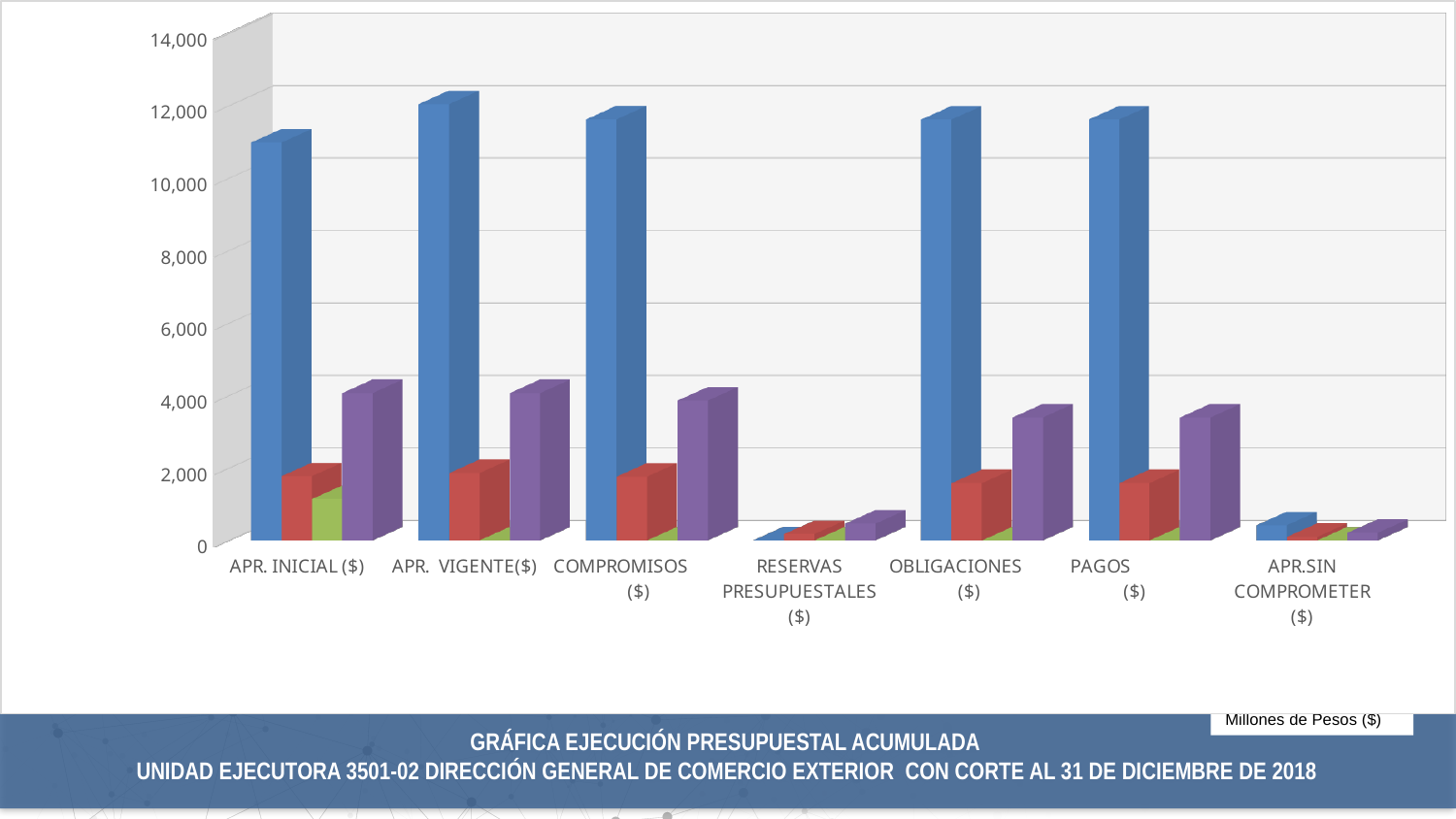
Which category has the tallest blue bar? APR. VIGENTE($) Is the red bar for COMPROMISOS ($) greater or less than 4,000? less Is the blue bar for APR. INICIAL ($) greater or less than 10,000? greater How many categories are shown along the x axis of the chart? 7 What kind of chart is shown on the slide? Bar chart Which is larger for PAGOS ($), the blue bar or the purple bar? The blue bar How many differently coloured bar series are plotted for each category? 4 Is the purple bar for OBLIGACIONES ($) greater or less than 4,000? less Which category has the lowest blue bar? RESERVAS PRESUPUESTALES ($) What unit is indicated for the values in the chart? Millones de Pesos ($) Which is larger, the blue bar for APR. INICIAL ($) or the blue bar for APR. VIGENTE($)? APR. VIGENTE($)